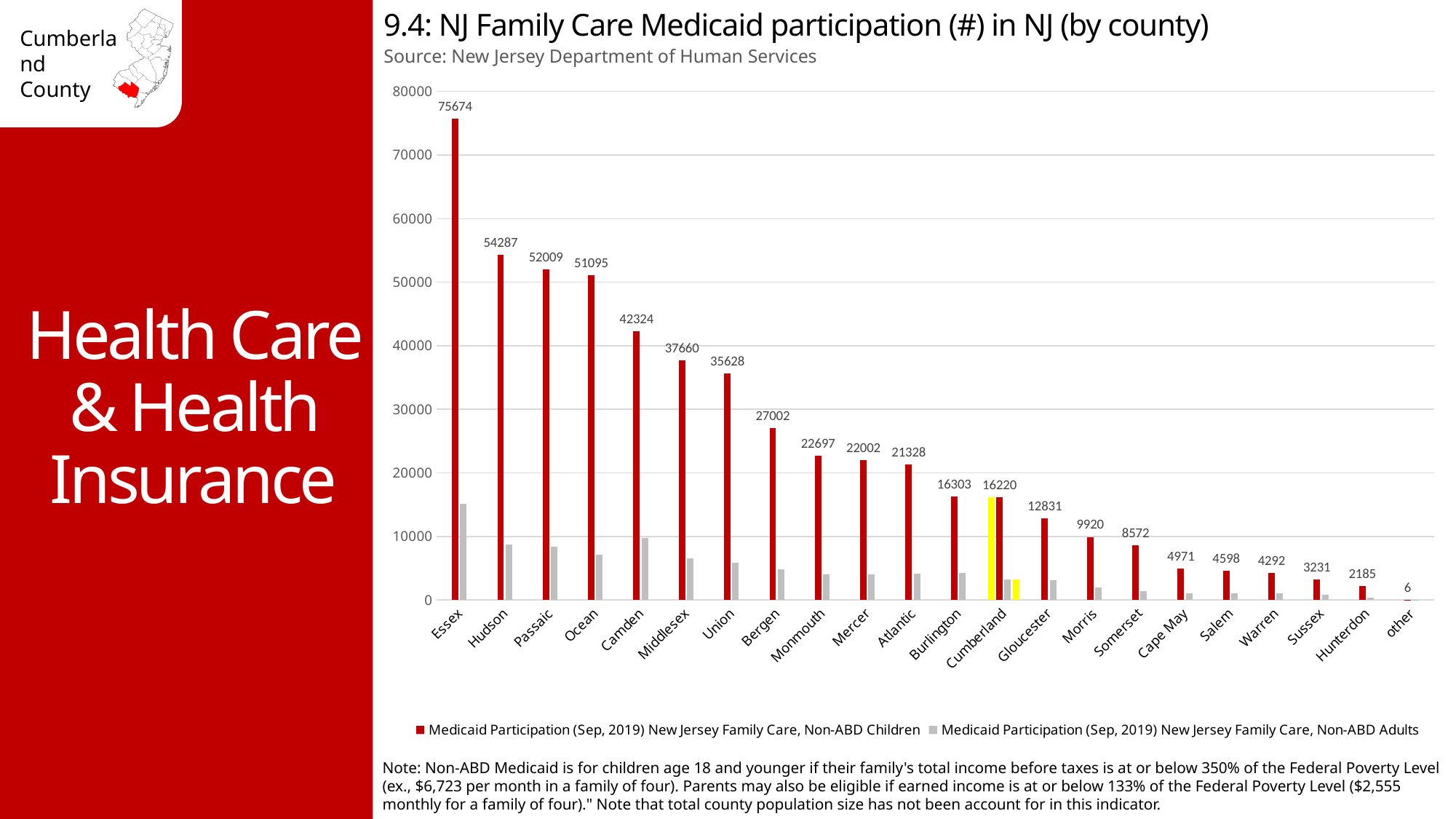
How many categories are shown on the x axis? 22 How many series does the legend list? 2 What is the Non-ABD Children Medicaid participation value for Cape May? 4971 What is the difference between the Non-ABD Children values for Hudson and Passaic? 2278 What kind of chart is shown on the slide? Bar chart Is the Non-ABD Adults value for Essex greater or less than 10000? greater What is the Non-ABD Children Medicaid participation value for Cumberland? 16220 Which labeled county (excluding 'other') has the lowest Non-ABD Children Medicaid participation? Hunterdon Which county has the highest Non-ABD Children Medicaid participation? Essex What is the Non-ABD Children Medicaid participation value for Essex? 75674 Which has a larger Non-ABD Children value, Camden or Middlesex? Camden Do the Non-ABD Children values rise or fall from left to right along the x axis? Fall